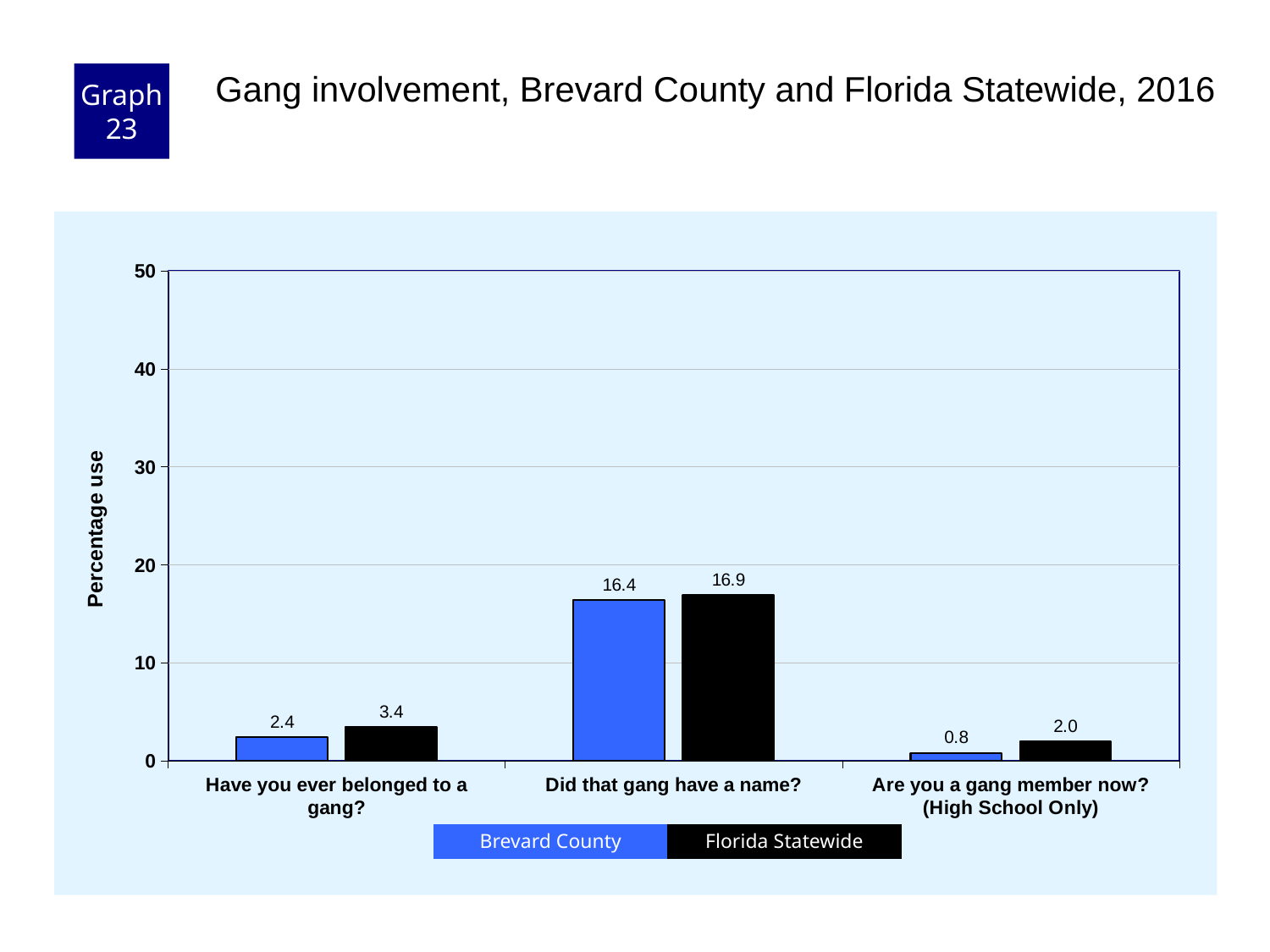
What is the Brevard County value for "Are you a gang member now? (High School Only)"? 0.8 What is the Florida Statewide value for "Have you ever belonged to a gang?"? 3.4 Which question has the lowest Brevard County value? Are you a gang member now? (High School Only) Which question has the highest Florida Statewide value? Did that gang have a name? Is the Florida Statewide value for "Did that gang have a name?" greater or less than 20? less What is the label of the y axis? Percentage use For "Have you ever belonged to a gang?", which is larger: Brevard County or Florida Statewide? Florida Statewide What is the difference between the Florida Statewide and Brevard County values for "Are you a gang member now? (High School Only)"? 1.2 How many series does the legend list? 2 What kind of chart is shown on the slide? Bar chart How many questions (categories) are shown on the x axis? 3 What is the Brevard County value for "Did that gang have a name?"? 16.4